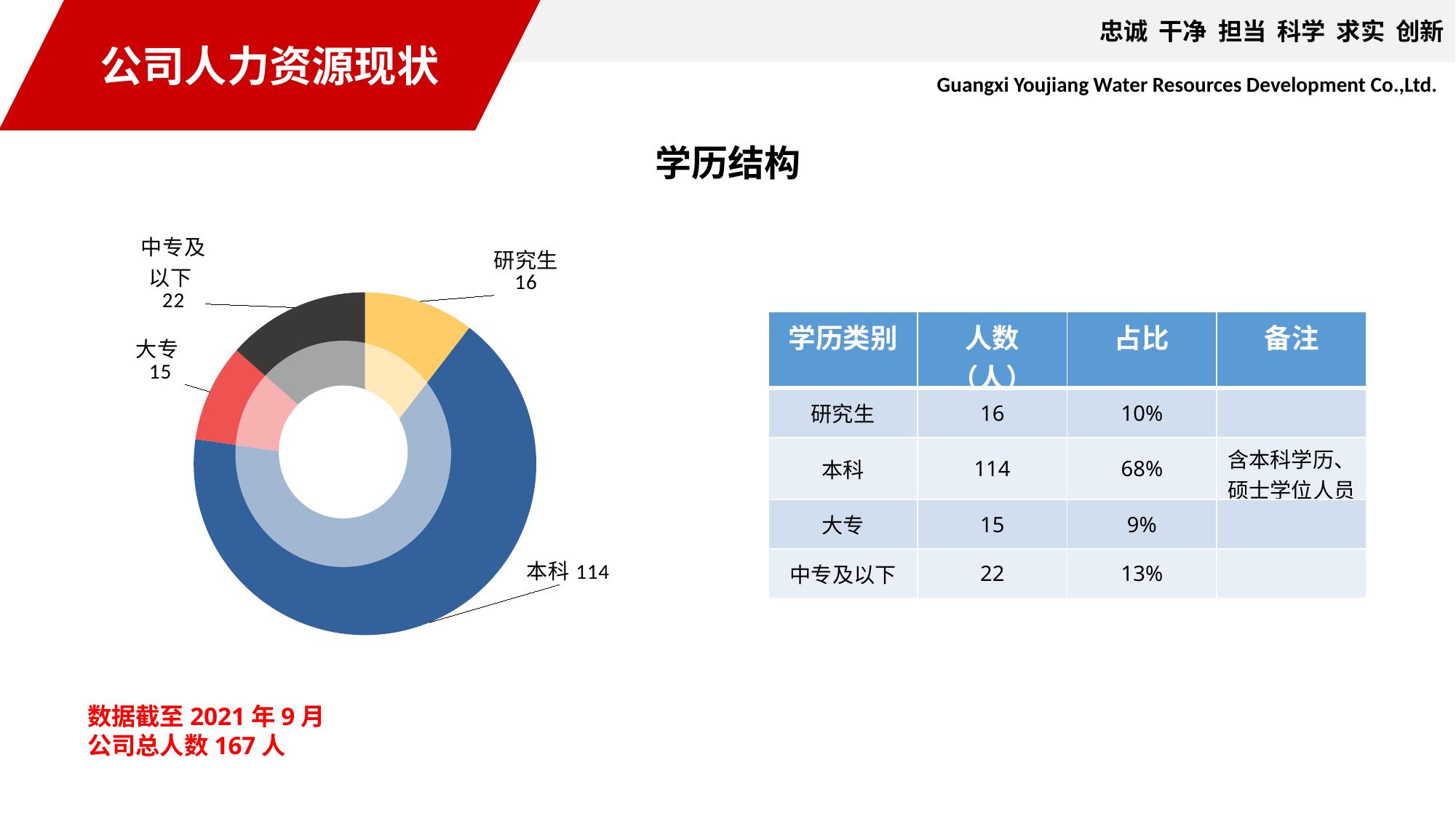
What is the value for 大专 in the 学历结构 chart? 15 What is the value for 本科 in the 学历结构 chart? 114 What kind of chart is the 学历结构 chart? Doughnut chart What is the value for 中专及以下 in the 学历结构 chart? 22 Which category has the smallest value in the 学历结构 chart? 大专 What is the value for 研究生 in the 学历结构 chart? 16 What is the difference between the values for 本科 and 中专及以下 in the 学历结构 chart? 92 What is the title of the chart on the slide? 学历结构 How many categories are shown in the 学历结构 chart? 4 Which is larger in the 学历结构 chart, 中专及以下 or 研究生? 中专及以下 What share of the total does 本科 represent in the 学历结构 chart? 68% Which category has the largest value in the 学历结构 chart? 本科